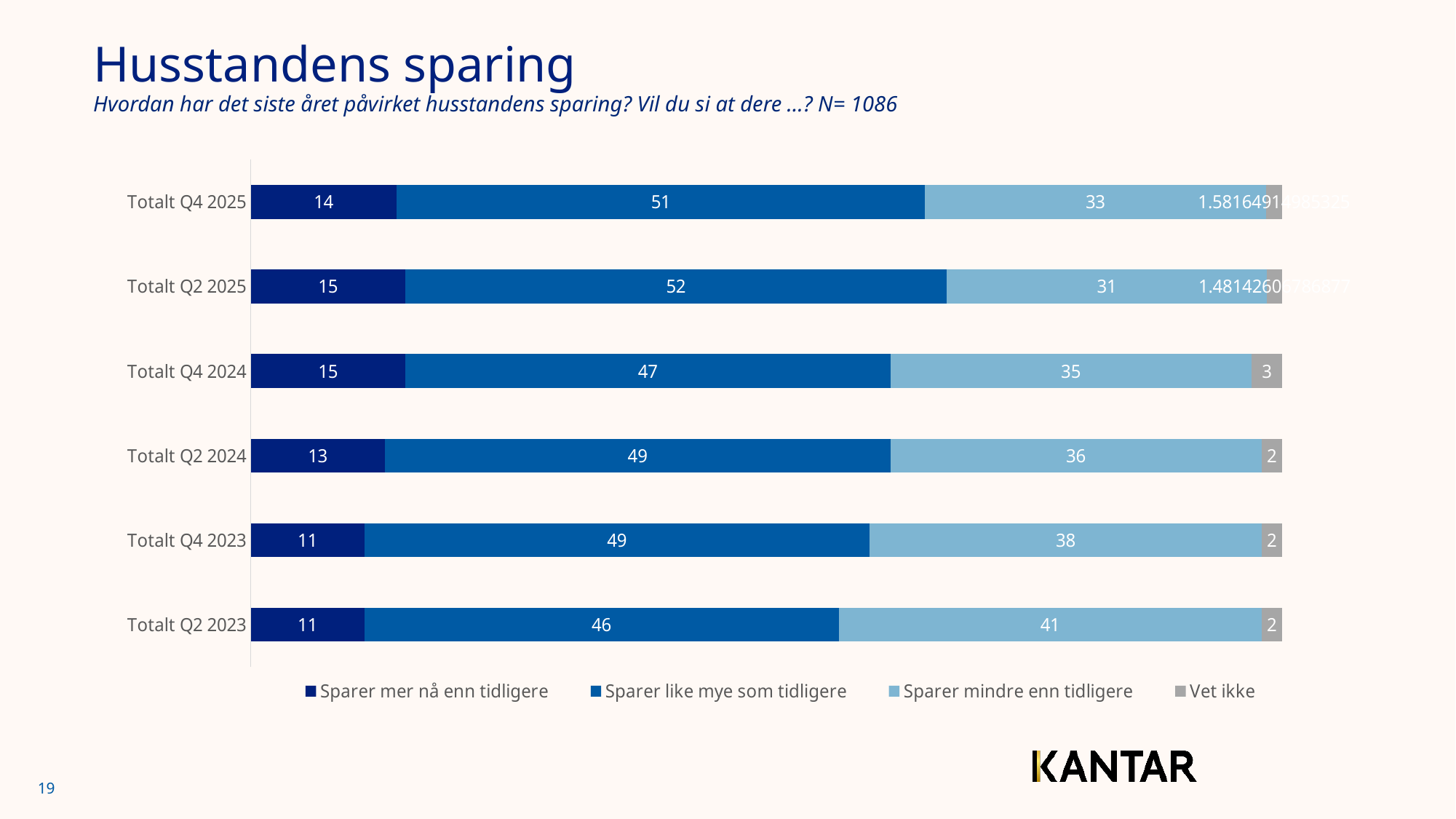
Which is larger: 'Sparer mer nå enn tidligere' in Totalt Q2 2025 or in Totalt Q4 2023? Totalt Q2 2025 How many categories (time periods) are shown on the chart? 6 What kind of chart is shown on the slide? stacked bar chart What is the value for 'Vet ikke' in Totalt Q4 2024? 3 Which category has the lowest value for 'Sparer like mye som tidligere'? Totalt Q2 2023 What is the title of the chart on the slide? Husstandens sparing What is the value for 'Sparer like mye som tidligere' in Totalt Q4 2025? 51 What is the total of the stacked bar for Totalt Q4 2024? 100 How many series does the legend list? 4 Which category has the highest value for 'Sparer mindre enn tidligere'? Totalt Q2 2023 What is the value for 'Sparer mindre enn tidligere' in Totalt Q2 2023? 41 What is the difference between the 'Sparer mindre enn tidligere' values for Totalt Q2 2023 and Totalt Q2 2025? 10